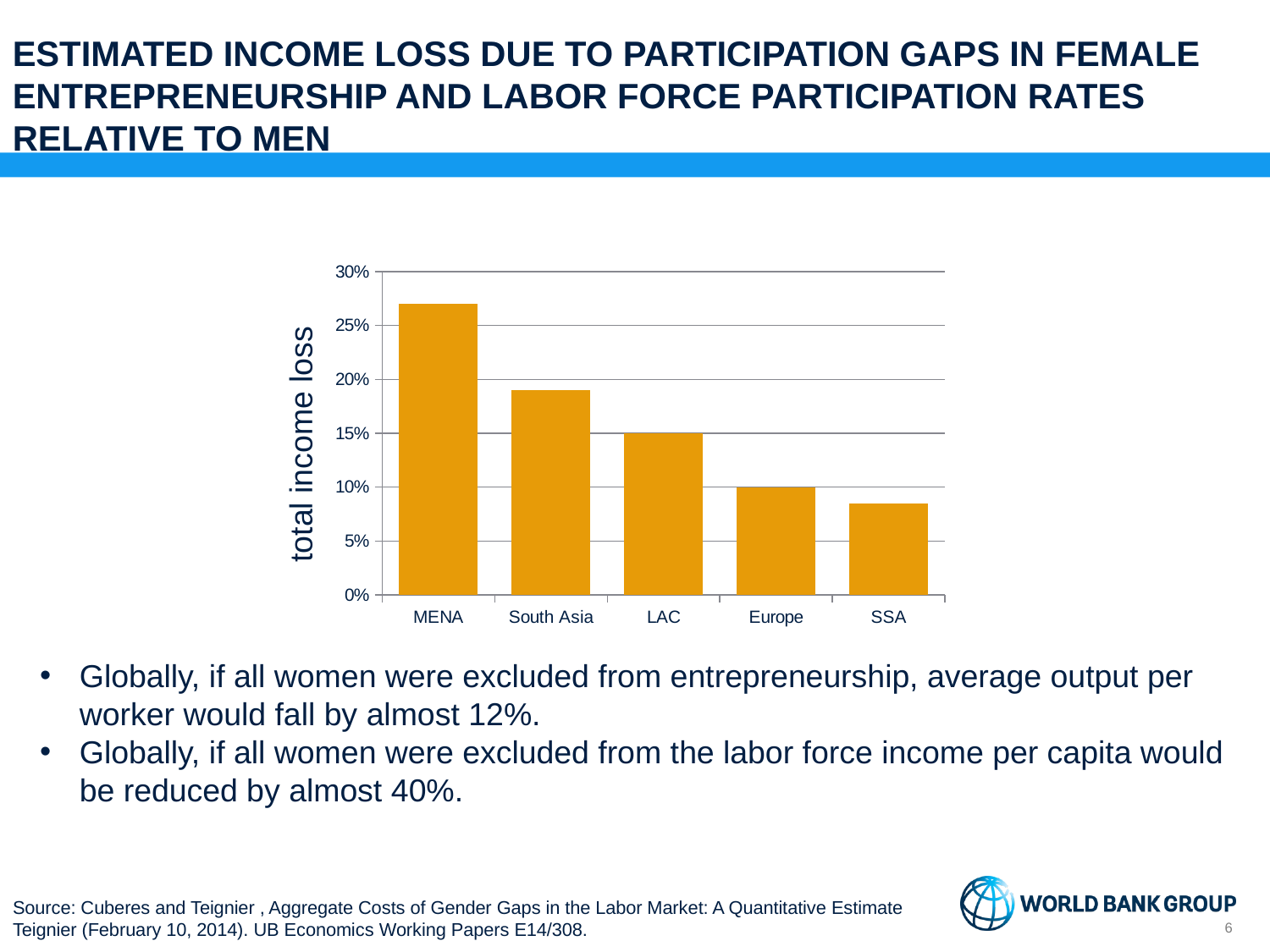
Is the value for South Asia greater or less than 15%? greater Do the values rise or fall moving from MENA to SSA along the x axis? Fall Which has a larger total income loss, South Asia or Europe? South Asia What kind of chart is shown on the slide? Bar chart Is the value for South Asia greater or less than 20%? less Is the value for MENA greater or less than 25%? greater How many regions are shown on the chart? 5 Which region has the highest estimated total income loss? MENA What is the total income loss for LAC? 15% What is the total income loss for Europe? 10% Which region has the lowest estimated total income loss? SSA